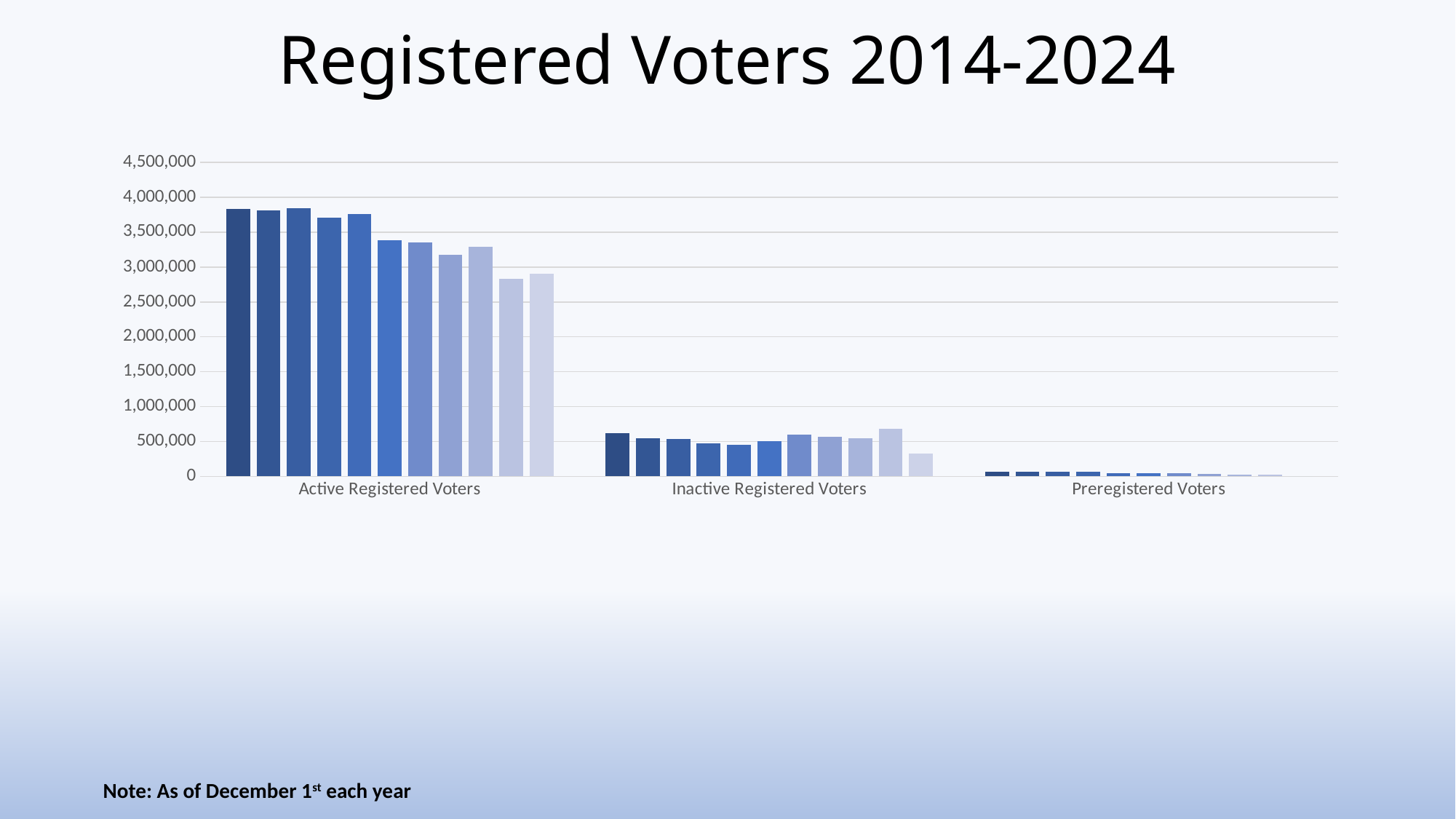
Are the bars for Preregistered Voters greater or less than 500,000? less What kind of chart is shown on the slide? Bar chart What is the title of the chart? Registered Voters 2014-2024 Is the tallest bar for Inactive Registered Voters greater or less than 1,000,000? less Is the first (leftmost) bar for Active Registered Voters greater or less than 3,500,000? greater How many categories are shown on the x axis? 3 Do the bars for Active Registered Voters generally rise or fall from left to right? fall Which category has the shortest bars? Preregistered Voters Which category has the tallest bars? Active Registered Voters Which is larger, the leftmost bar for Active Registered Voters or the leftmost bar for Inactive Registered Voters? Active Registered Voters How many bars are plotted in the Active Registered Voters group? 11